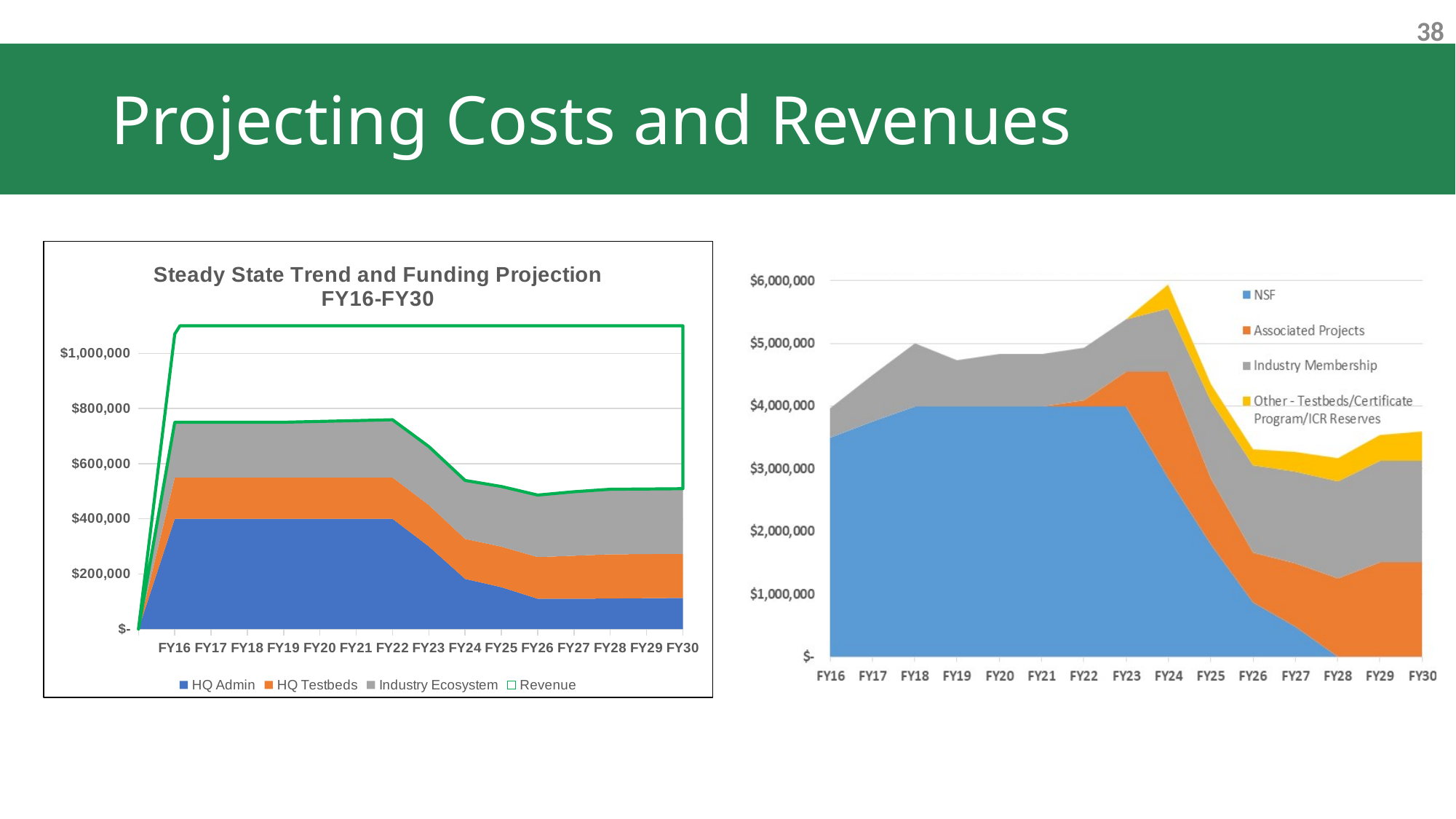
On the left chart titled 'Steady State Trend and Funding Projection FY16-FY30', is the HQ Admin value for FY30 greater or less than $200,000? less On the right chart, is the NSF value for FY28 greater or less than $1,000,000? less On the right chart, does the NSF area rise or fall from FY24 to FY28? fall On the left chart titled 'Steady State Trend and Funding Projection FY16-FY30', how many fiscal years are shown on the x axis? 15 On the right chart, how many series does the legend list? 4 On the left chart titled 'Steady State Trend and Funding Projection FY16-FY30', which series is drawn as a green outline line rather than a filled area? Revenue On the left chart titled 'Steady State Trend and Funding Projection FY16-FY30', does the HQ Admin area rise or fall from FY22 to FY26? fall On the right chart, what kind of chart is it? stacked area chart On the right chart, is the NSF value for FY16 greater or less than $3,000,000? greater On the left chart titled 'Steady State Trend and Funding Projection FY16-FY30', how many series does the legend list? 4